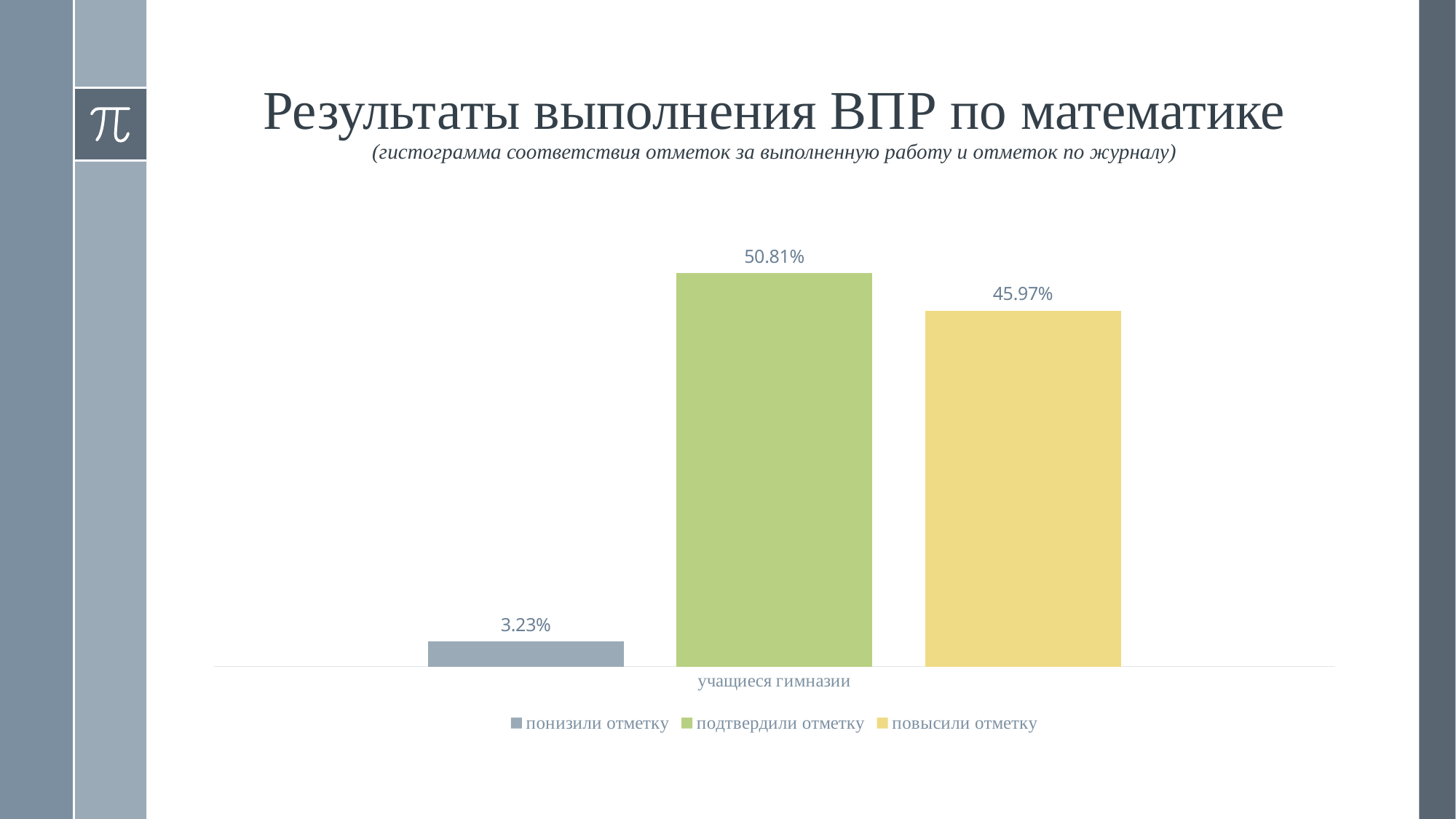
What is the difference between the values for "подтвердили отметку" and "повысили отметку"? 4.84% What is the category label shown on the x axis? учащиеся гимназии What colour is the bar for "повысили отметку"? yellow What is the value for "повысили отметку"? 45.97% How many series does the legend list? 3 What is the difference between the values for "повысили отметку" and "понизили отметку"? 42.74% Which series has the lowest value? понизили отметку Which series has the highest value? подтвердили отметку What is the value for "понизили отметку"? 3.23% Which is larger, the value for "подтвердили отметку" or the value for "повысили отметку"? подтвердили отметку What kind of chart is shown on the slide? bar chart What is the value for "подтвердили отметку"? 50.81%